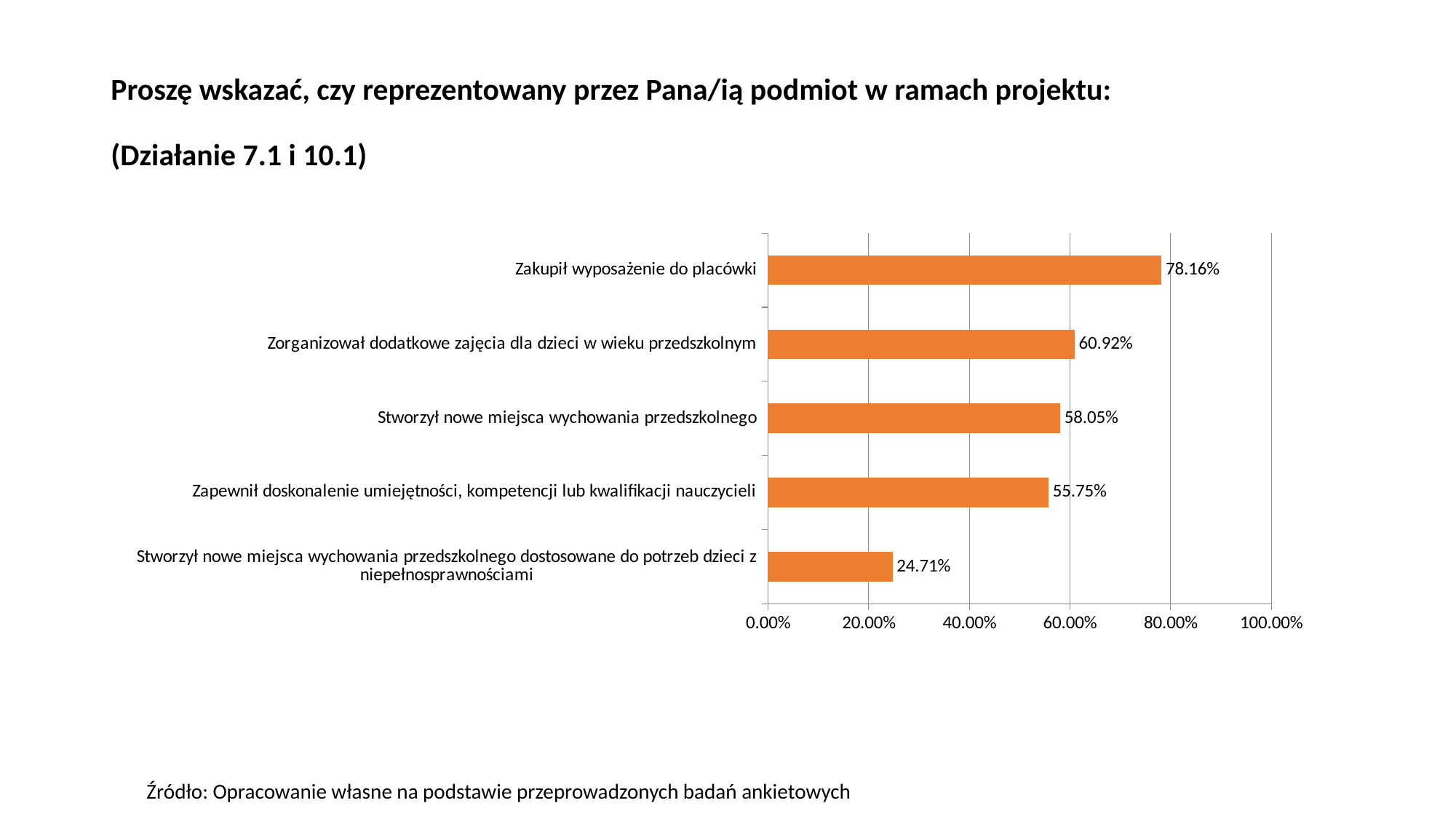
Which is larger: the value for "Stworzył nowe miejsca wychowania przedszkolnego" or for "Zapewnił doskonalenie umiejętności, kompetencji lub kwalifikacji nauczycieli"? Stworzył nowe miejsca wychowania przedszkolnego What is the value for "Stworzył nowe miejsca wychowania przedszkolnego dostosowane do potrzeb dzieci z niepełnosprawnościami"? 24.71% How many categories are shown in the chart? 5 What is the value for "Zakupił wyposażenie do placówki"? 78.16% Which category has the highest value? Zakupił wyposażenie do placówki What is the maximum value shown on the x axis? 100.00% Is the value for "Zorganizował dodatkowe zajęcia dla dzieci w wieku przedszkolnym" greater or less than 60.00%? greater What kind of chart is shown on the slide? bar chart What is the value for "Zorganizował dodatkowe zajęcia dla dzieci w wieku przedszkolnym"? 60.92% What is the difference between the values for "Zakupił wyposażenie do placówki" and "Zapewnił doskonalenie umiejętności, kompetencji lub kwalifikacji nauczycieli"? 22.41% What colour are the bars in the chart? orange Which category has the lowest value? Stworzył nowe miejsca wychowania przedszkolnego dostosowane do potrzeb dzieci z niepełnosprawnościami